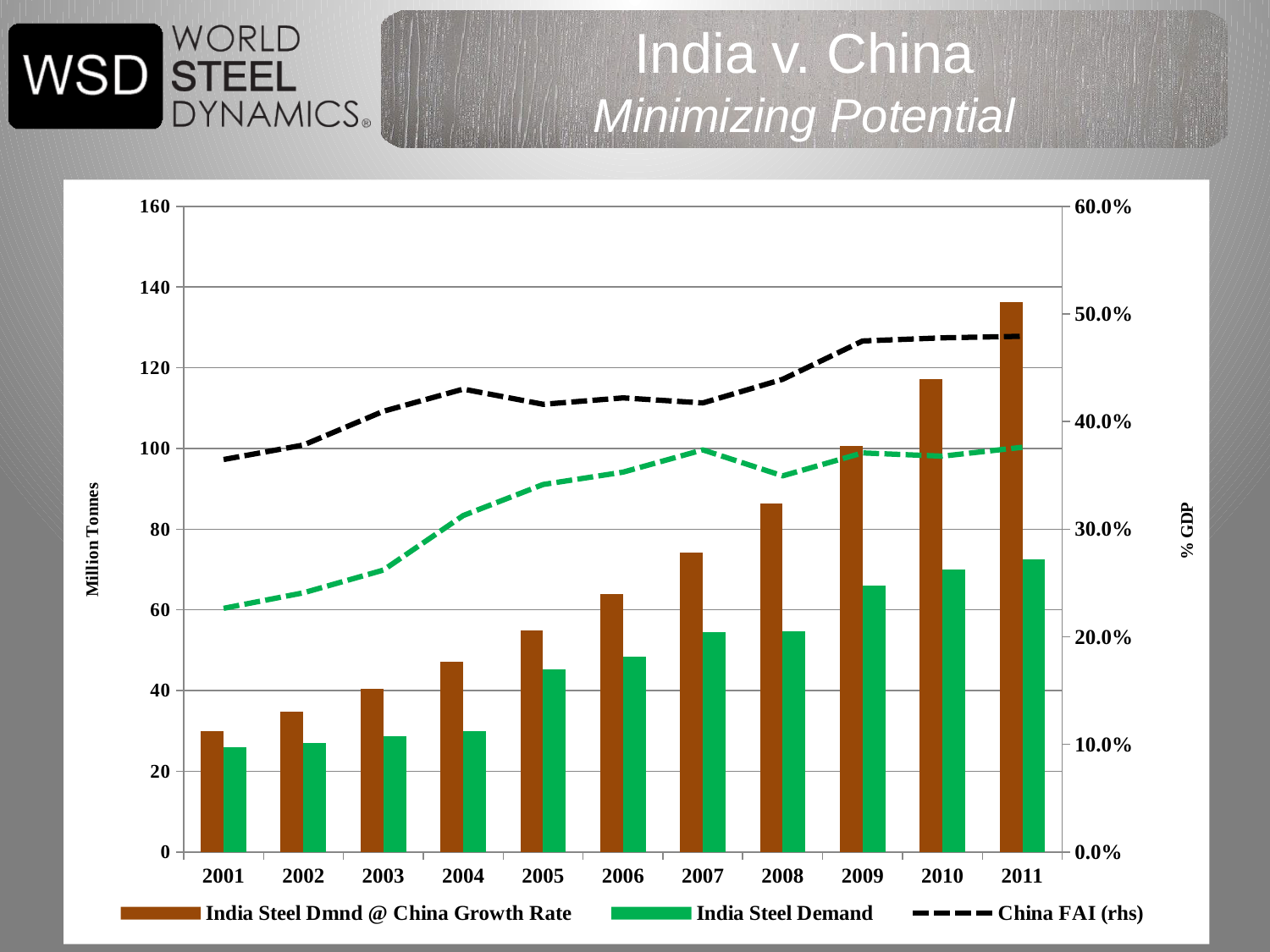
Is the India Steel Dmnd @ China Growth Rate value for 2011 greater or less than 120? greater What kind of chart is shown on the slide? Bar chart with dashed lines (combination chart) Is the India Steel Demand value for 2004 greater or less than 40? less In which year is the India Steel Dmnd @ China Growth Rate bar the highest? 2011 In 2011, which is larger: India Steel Dmnd @ China Growth Rate or India Steel Demand? India Steel Dmnd @ China Growth Rate What is the label on the right-hand vertical axis of the chart? % GDP Is the India Steel Demand value for 2011 greater or less than 80? less In which year is the India Steel Dmnd @ China Growth Rate bar the lowest? 2001 Do the India Steel Dmnd @ China Growth Rate bars rise or fall from 2001 to 2011? rise How many series does the chart's legend list? 3 How many years are shown on the x axis of the chart? 11